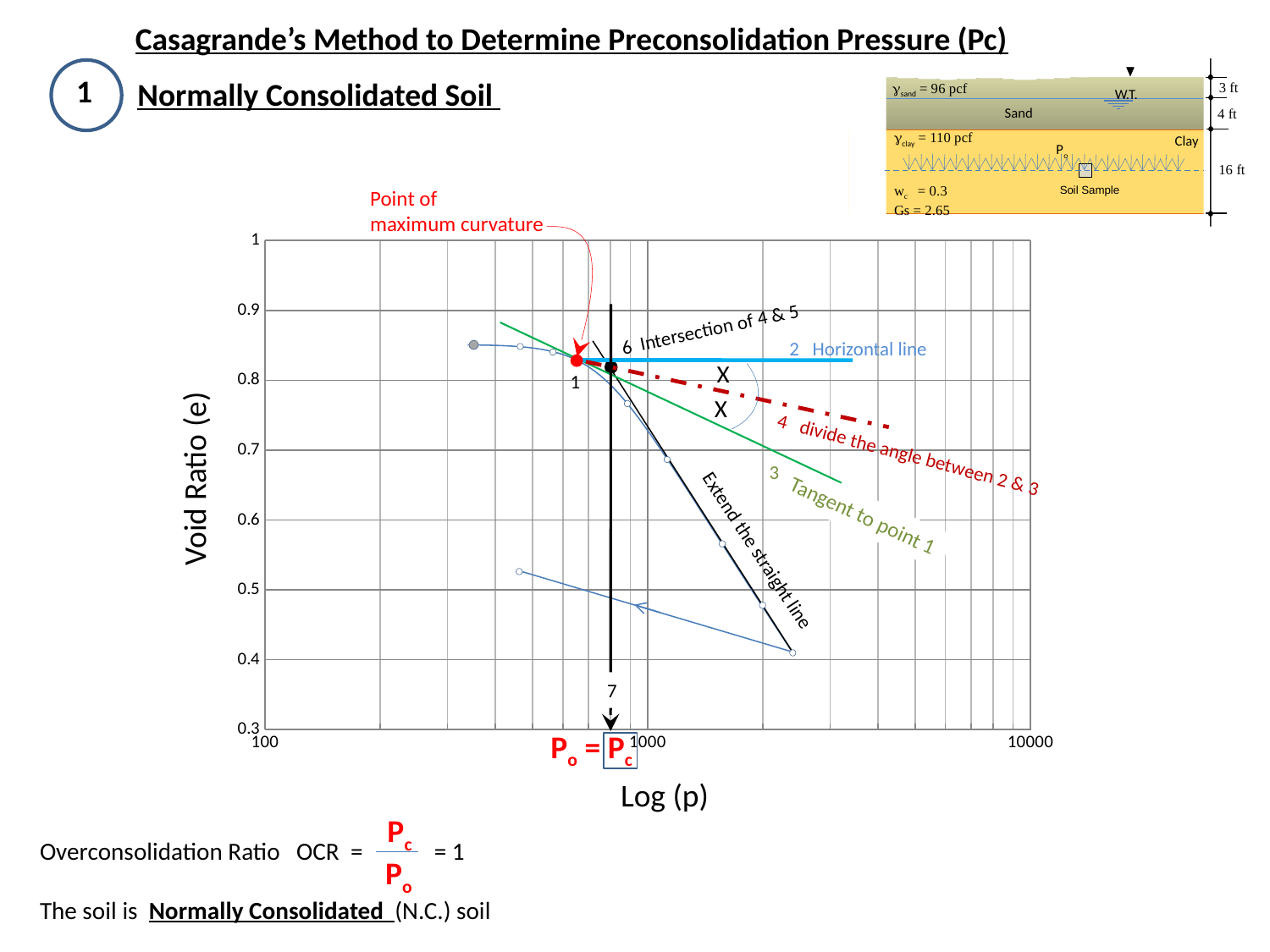
Is the void ratio of the first (leftmost) data point on the loading curve greater or less than 0.8? greater Is the void ratio at the point of maximum curvature (point 1) greater or less than 0.9? less Along the main loading curve, does the void ratio rise or fall as the pressure p increases? Fall Is the void ratio of the leftmost point on the unloading (rebound) line greater or less than 0.5? greater What is the label of the vertical axis of the chart? Void Ratio (e) What kind of chart is shown on the slide? Line chart What is the highest value shown on the vertical axis of the chart? 1 Which has the higher void ratio: the leftmost point on the loading curve or the lowest point on the loading curve? The leftmost point on the loading curve What is the label of the horizontal axis of the chart? Log (p)